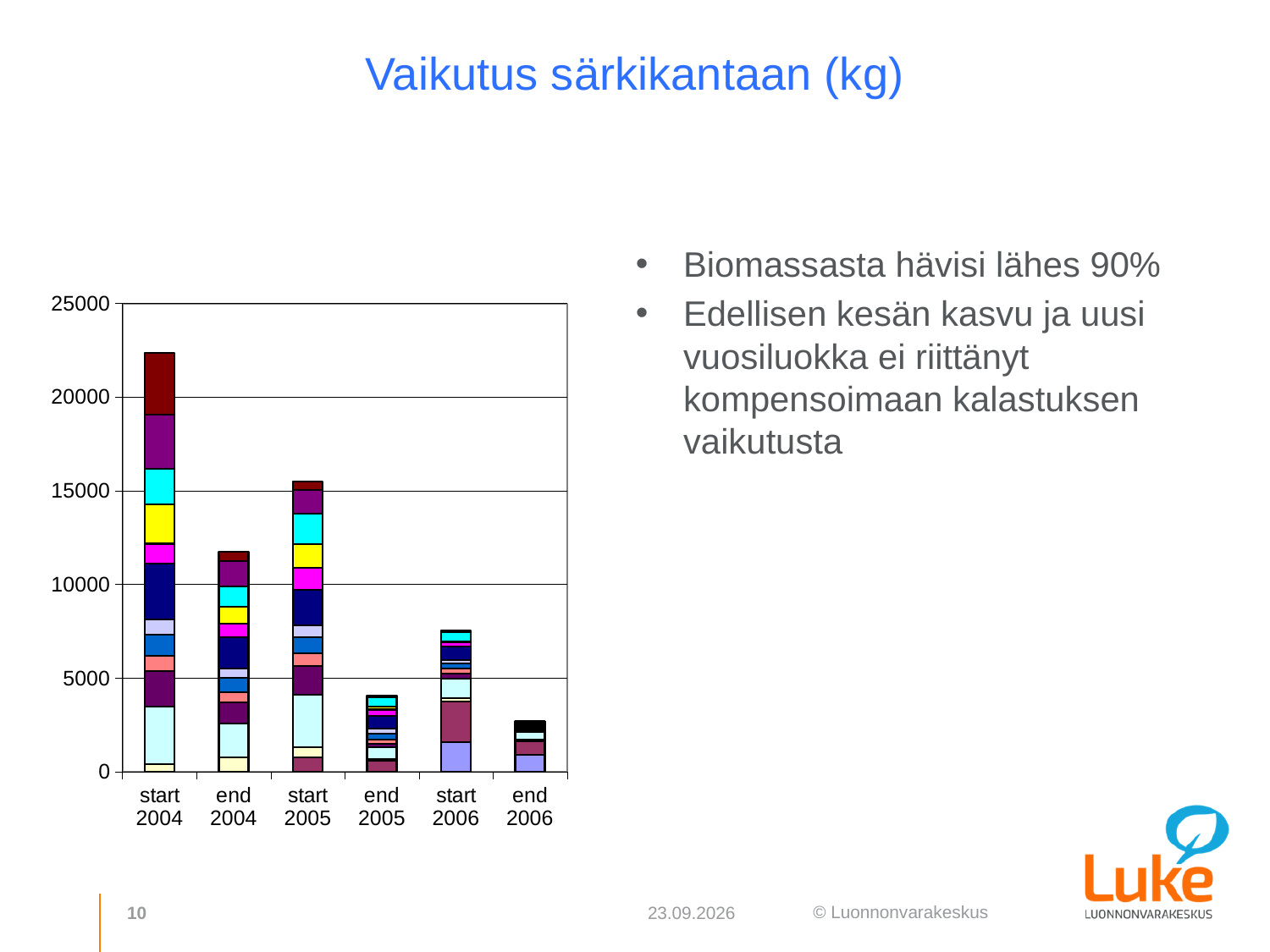
How many categories are shown on the x axis of the chart? 6 Is the total value for end 2004 greater or less than 10000? greater Which category has the tallest stacked bar? start 2004 Is the total value for start 2006 greater or less than 5000? greater Which category has the shortest stacked bar? end 2006 Do the 'start' bars rise or fall from 2004 to 2006? fall What kind of chart is shown on the slide? Stacked bar chart Which bar is taller, end 2004 or end 2005? end 2004 Is the total value for start 2004 greater or less than 20000? greater Which bar is taller, start 2004 or start 2005? start 2004 What is the title of the chart on the slide? Vaikutus särkikantaan (kg)